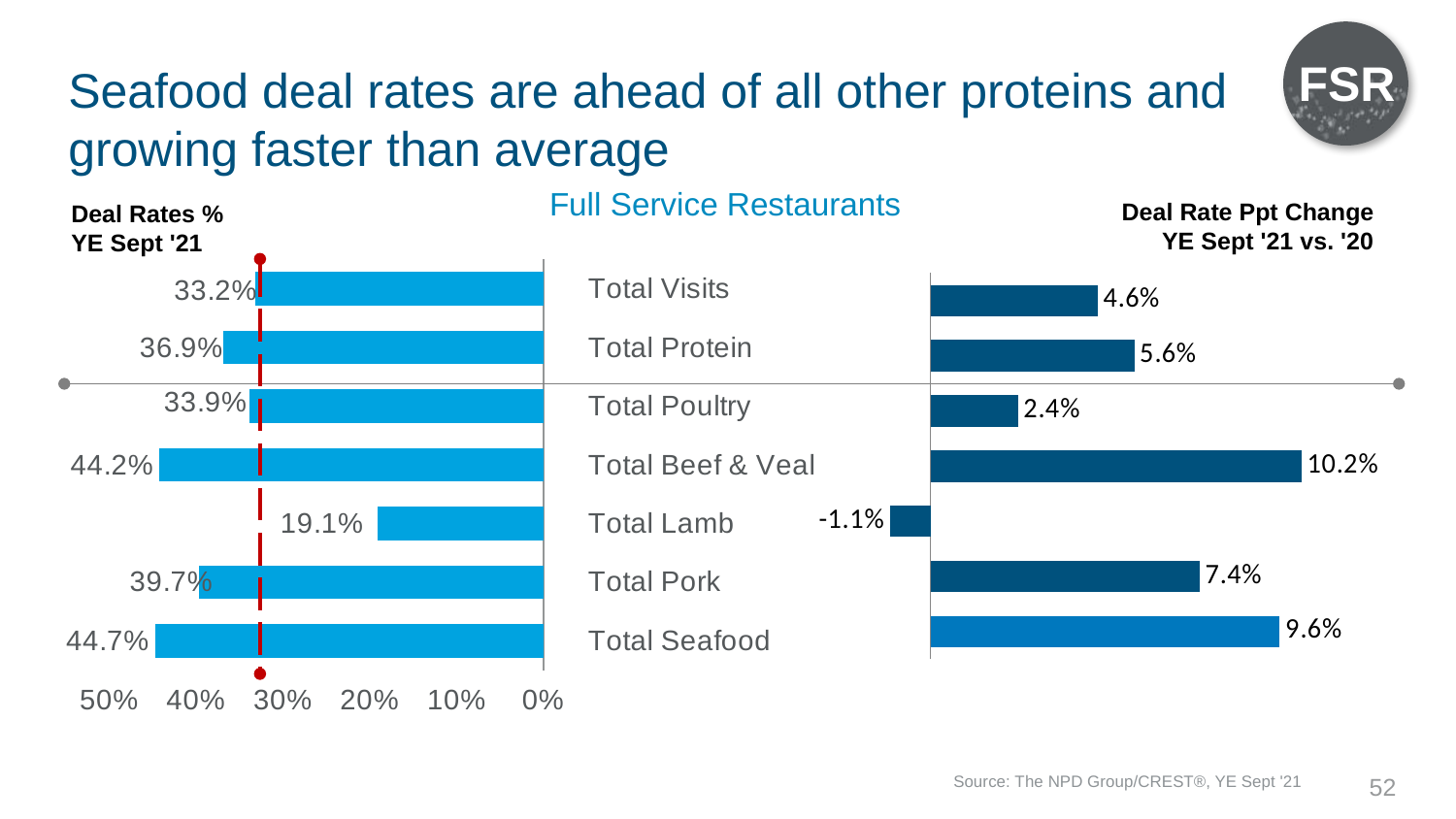
In the Deal Rates % YE Sept '21 chart, what is the difference between the deal rates for Total Seafood and Total Beef & Veal? 0.5 percentage points What kind of chart is the Deal Rate Ppt Change YE Sept '21 vs. '20 chart? Bar chart In the Deal Rates % YE Sept '21 chart, what is the deal rate for Total Seafood? 44.7% How many categories are shown in the Deal Rates % YE Sept '21 chart? 7 In the Deal Rates % YE Sept '21 chart, which category has the lowest deal rate? Total Lamb In the Deal Rate Ppt Change YE Sept '21 vs. '20 chart, what is the value for Total Lamb? -1.1% In the Deal Rate Ppt Change YE Sept '21 vs. '20 chart, which is larger, Total Protein or Total Visits? Total Protein In the Deal Rate Ppt Change YE Sept '21 vs. '20 chart, which category has the highest change? Total Beef & Veal In the Deal Rate Ppt Change YE Sept '21 vs. '20 chart, what is the difference between Total Pork and Total Poultry? 5.0 percentage points In the Deal Rate Ppt Change YE Sept '21 vs. '20 chart, what is the value for Total Beef & Veal? 10.2% In the Deal Rates % YE Sept '21 chart, what is the deal rate for Total Lamb? 19.1% In the Deal Rate Ppt Change YE Sept '21 vs. '20 chart, which category has the lowest change? Total Lamb